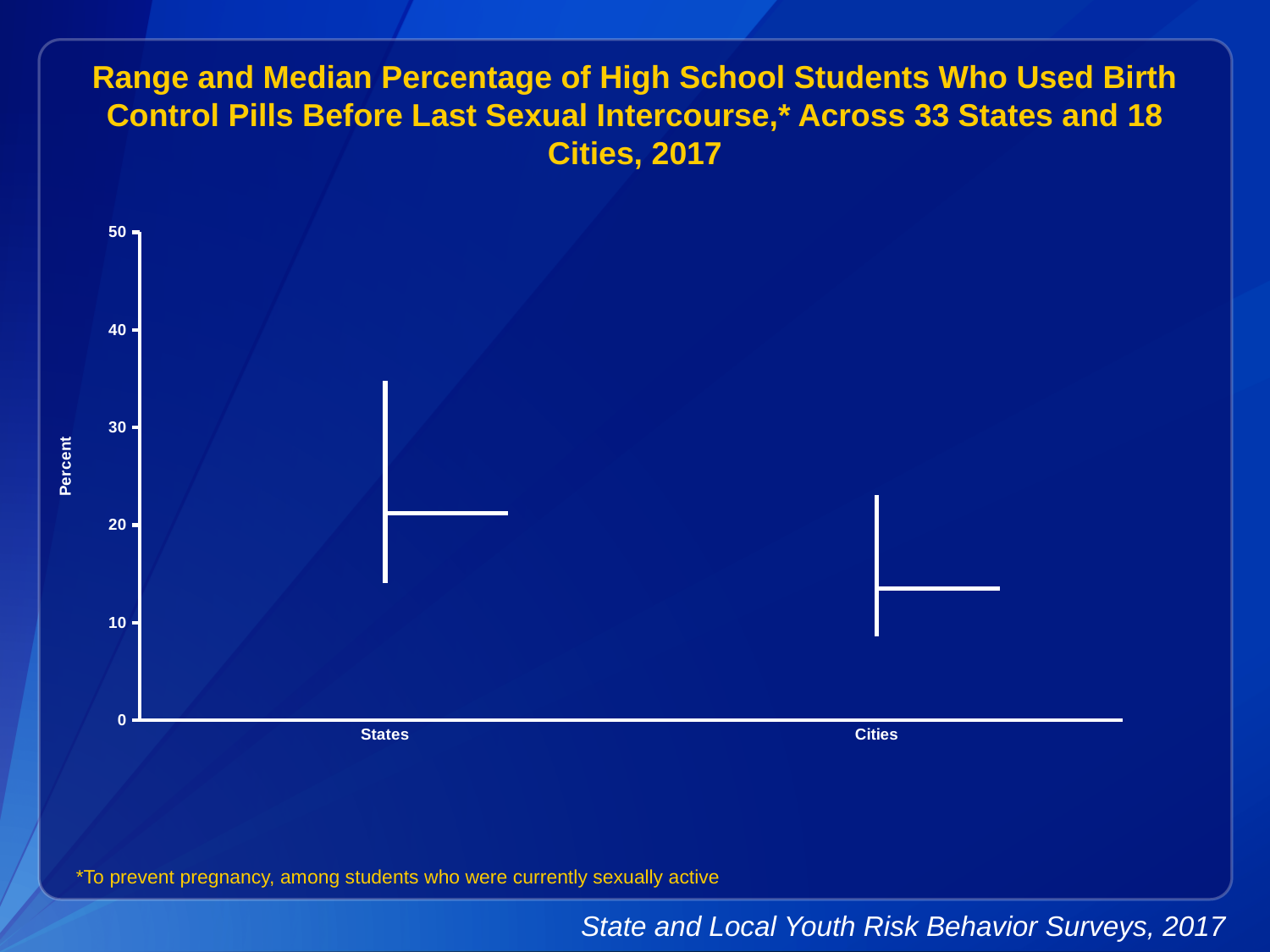
What is the label on the y axis of the chart? Percent Which category has the higher median percentage, States or Cities? States Is the bottom of the range for States greater or less than 10? greater Is the top of the range for States greater or less than 30? greater Is the median value for Cities greater or less than 20? less Which category has the higher top of its range, States or Cities? States How many categories are shown on the x axis of the chart? 2 What is the highest value shown on the y axis of the chart? 50